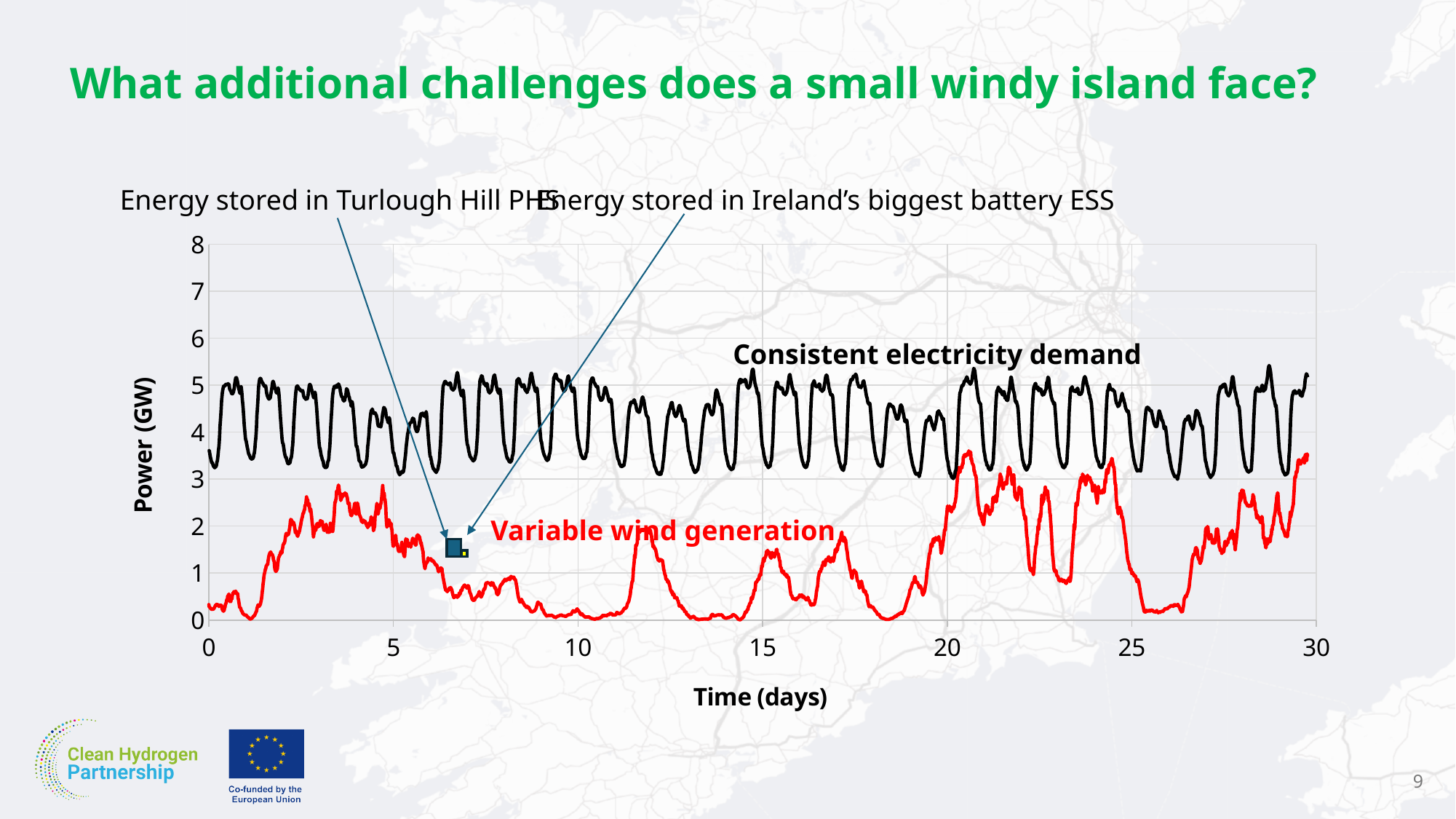
Which series has the higher values across the whole chart, Consistent electricity demand or Variable wind generation? Consistent electricity demand Are the peaks of Consistent electricity demand greater or less than 6? less Is the value of Variable wind generation at day 10 greater or less than 1? less Is the value of Variable wind generation at day 0 greater or less than 1? less What is the label of the x axis of the chart? Time (days) At day 10, which series has the larger value, Consistent electricity demand or Variable wind generation? Consistent electricity demand What is the label of the y axis of the chart? Power (GW) How many data series are plotted on the chart? 2 What kind of chart is shown on the slide? line chart